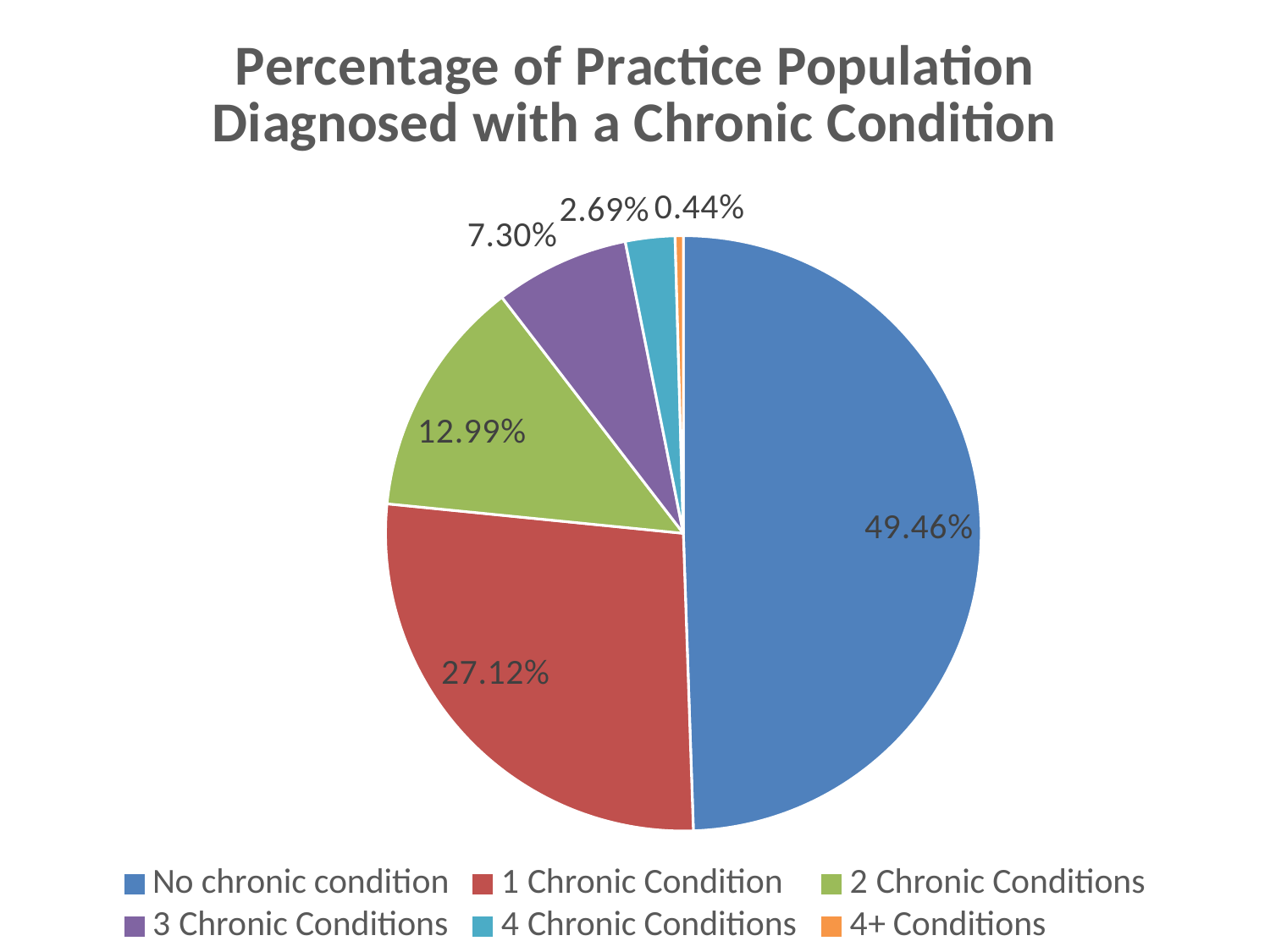
Which category has the smallest slice of the pie? 4+ Conditions Which is larger: the share with 2 chronic conditions or the share with 3 chronic conditions? 2 Chronic Conditions Which category has the largest slice of the pie? No chronic condition What percentage of the practice population has 2 chronic conditions? 12.99% How many categories does the legend list? 6 What percentage of the practice population has 4+ conditions? 0.44% What percentage of the practice population has 3 chronic conditions? 7.30% What percentage of the practice population has 1 chronic condition? 27.12% What is the difference between the share with no chronic condition and the share with 1 chronic condition? 22.34% What percentage of the practice population has no chronic condition? 49.46% What is the title of the chart? Percentage of Practice Population Diagnosed with a Chronic Condition What kind of chart is shown on the slide? pie chart